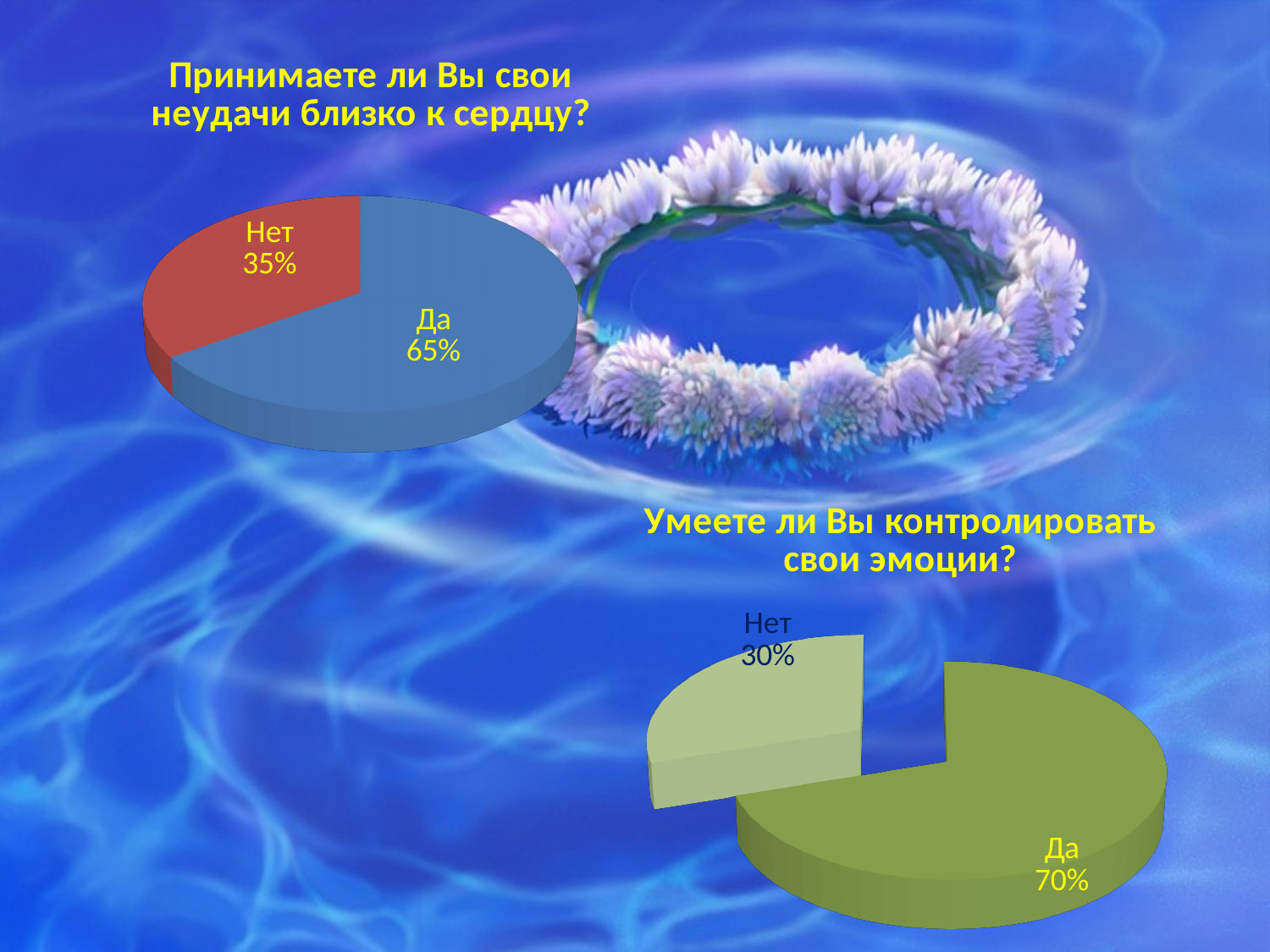
In the chart titled "Умеете ли Вы контролировать свои эмоции?", which answer has the smallest share? Нет In the chart titled "Умеете ли Вы контролировать свои эмоции?", what percentage answered "Да"? 70% What type of chart is used in the top-left chart on the slide? Pie chart In the chart titled "Принимаете ли Вы свои неудачи близко к сердцу?", what colour is the "Нет" slice? Red Which is larger: the "Да" share in the top-left chart or the "Да" share in the bottom-right chart? The bottom-right chart (70%) In the chart titled "Умеете ли Вы контролировать свои эмоции?", what is the difference in percentage points between "Да" and "Нет"? 40 In the chart titled "Умеете ли Вы контролировать свои эмоции?", what percentage answered "Нет"? 30% In the chart titled "Принимаете ли Вы свои неудачи близко к сердцу?", what percentage answered "Нет"? 35% In the chart titled "Принимаете ли Вы свои неудачи близко к сердцу?", which answer has the largest share? Да In the chart titled "Принимаете ли Вы свои неудачи близко к сердцу?", what percentage answered "Да"? 65% In the chart titled "Принимаете ли Вы свои неудачи близко к сердцу?", what is the difference in percentage points between "Да" and "Нет"? 30 How many slices does the chart titled "Умеете ли Вы контролировать свои эмоции?" have? 2